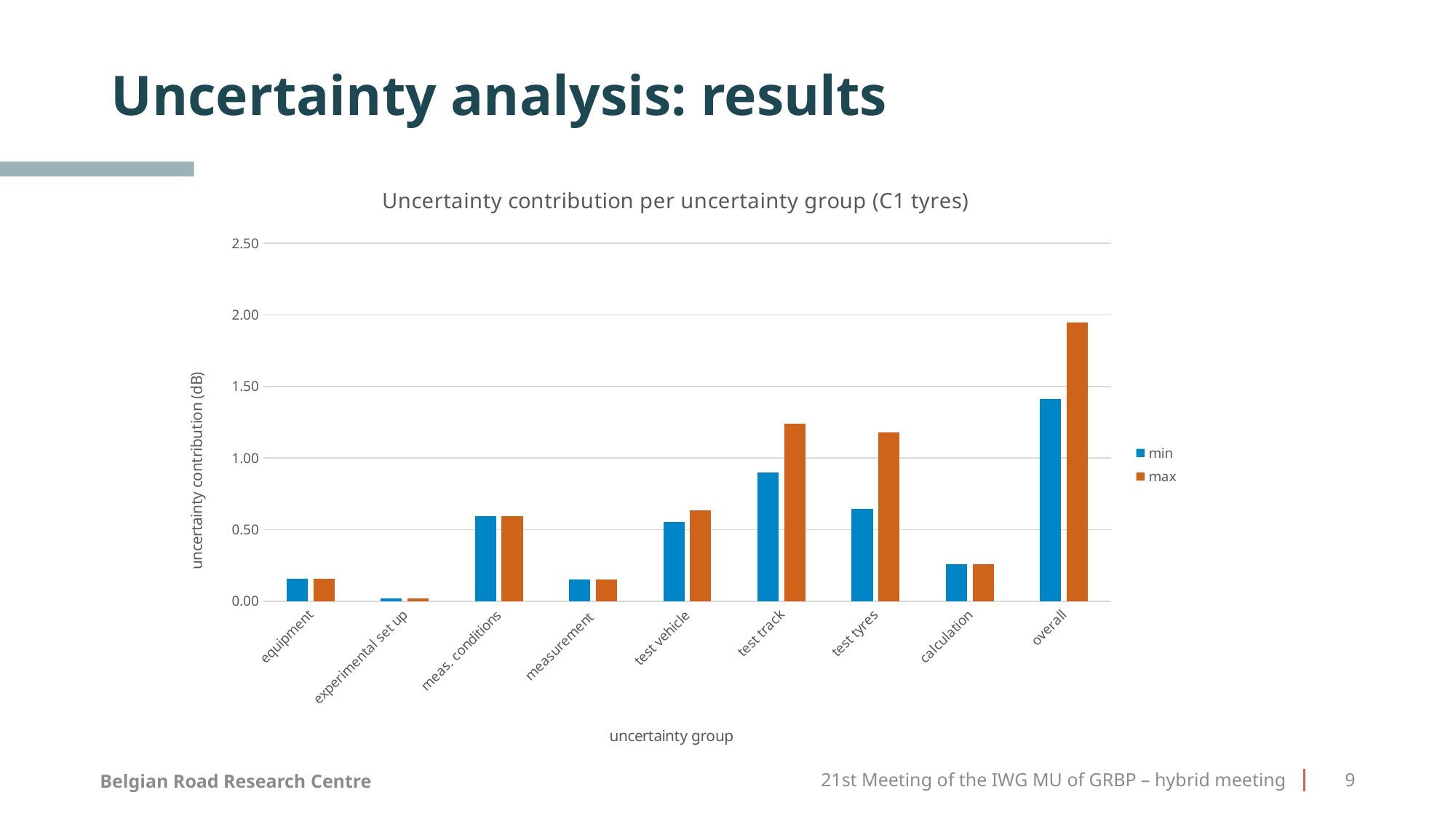
Is the max value for test track greater or less than 1.00? greater Which uncertainty group has the highest max uncertainty contribution? overall Which is larger, the min value for test track or the min value for test tyres? test track Is the min value for overall greater or less than 1.50? less What is the label of the y axis? uncertainty contribution (dB) What is the title of the chart? Uncertainty contribution per uncertainty group (C1 tyres) Which uncertainty group has the lowest min uncertainty contribution? experimental set up How many uncertainty groups are shown on the x axis? 9 What type of chart is shown on the slide? bar chart Is the max value for calculation greater or less than 0.50? less How many series does the legend list? 2